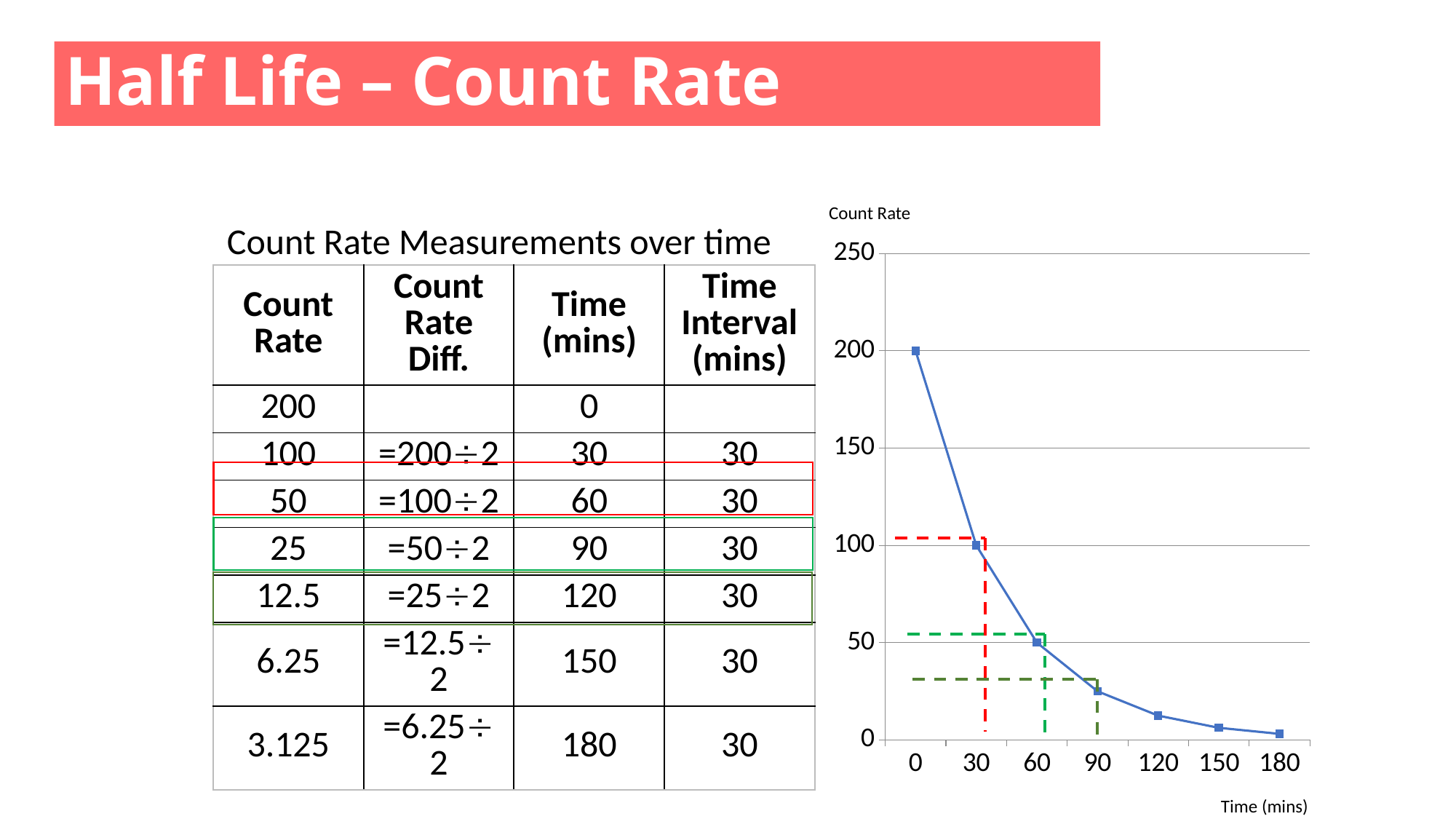
What is the difference between the count rate at 0 mins and at 30 mins? 100 At which time is the count rate lowest? 180 Is the count rate at 90 mins greater or less than 50? less What is the count rate at time 0 mins on the chart? 200 What is the count rate at time 60 mins on the chart? 50 Does the count rate rise or fall as time increases along the x axis? fall What is the label on the x axis of the chart? Time (mins) How many data points are plotted on the chart? 7 What kind of chart is shown on the slide? line chart Which has the larger count rate, 30 mins or 90 mins? 30 mins At which time is the count rate highest? 0 What is the count rate at time 30 mins on the chart? 100